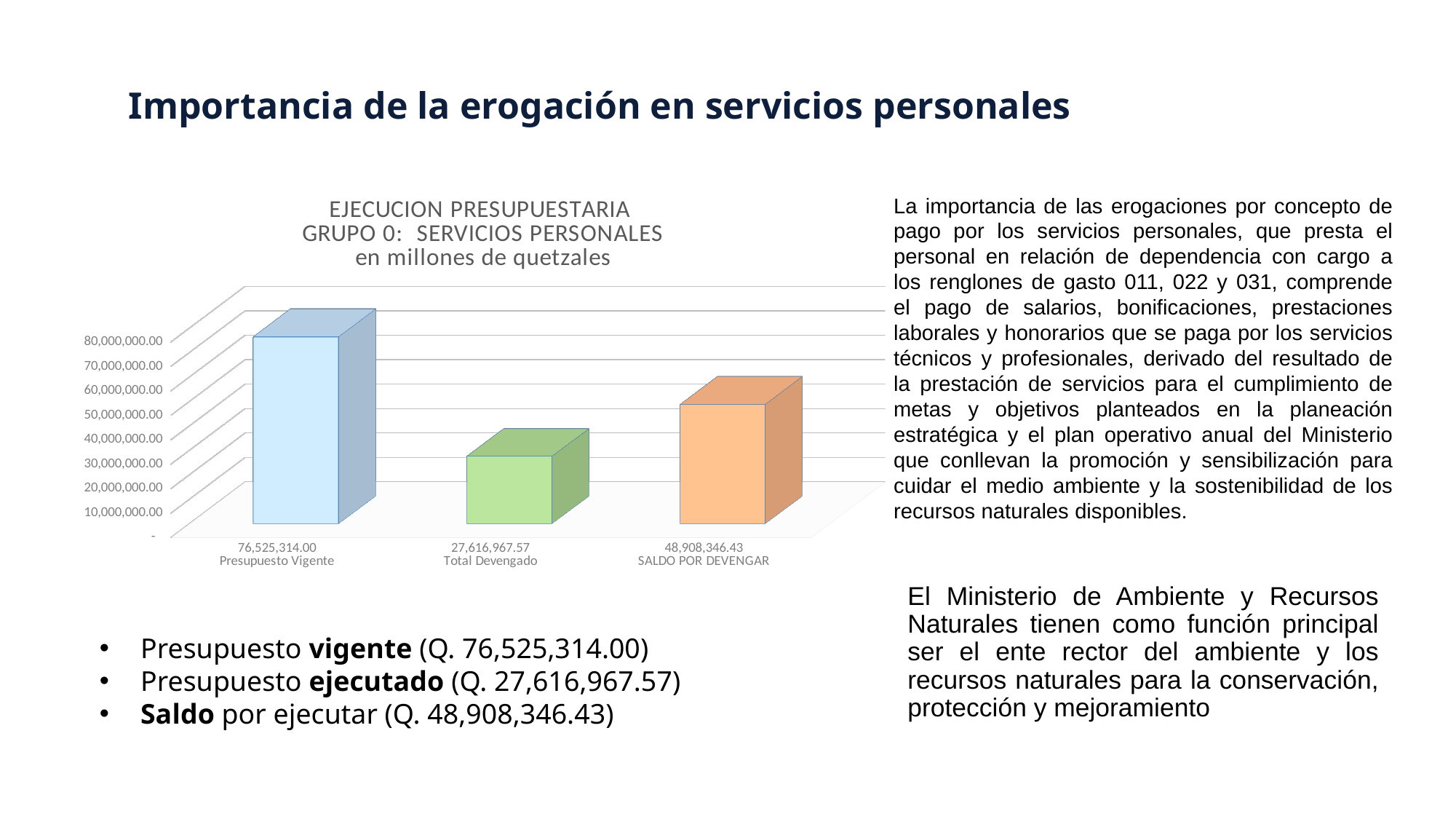
What is the difference between SALDO POR DEVENGAR and Total Devengado? 21,291,378.86 How many categories are shown in the chart? 3 Which is larger, SALDO POR DEVENGAR or Total Devengado? SALDO POR DEVENGAR What is the value for Presupuesto Vigente? 76,525,314.00 Which category has the highest value? Presupuesto Vigente What unit does the chart title say the values are in? millones de quetzales What is the value for Total Devengado? 27,616,967.57 What is the value for SALDO POR DEVENGAR? 48,908,346.43 What kind of chart is shown on the slide? bar chart Is the value for Total Devengado greater or less than 30,000,000.00? less What is the difference between Presupuesto Vigente and Total Devengado? 48,908,346.43 Which category has the lowest value? Total Devengado